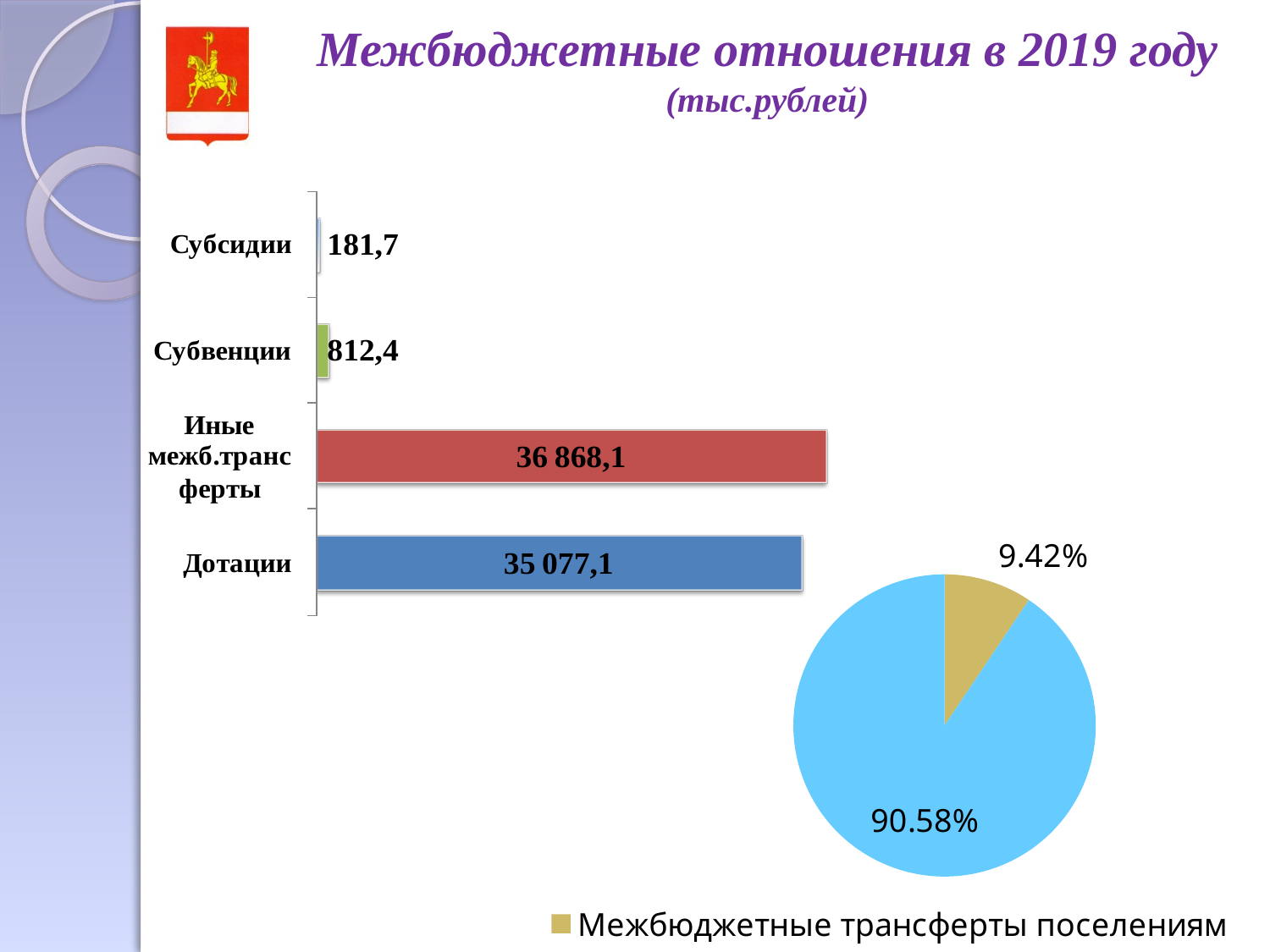
In the bar chart, what is the value for Субвенции? 812,4 In the bar chart, which is larger: Субвенции or Субсидии? Субвенции In the bar chart, what is the value for Субсидии? 181,7 In the bar chart, which category has the lowest value? Субсидии In the bar chart, what is the value for Иные межб.трансферты? 36 868,1 In the pie chart, what share does the slice for Межбюджетные трансферты поселениям have? 9.42% In the bar chart, which category has the highest value? Иные межб.трансферты In the pie chart, what is the percentage shown for the larger blue slice? 90.58% In the bar chart, what is the difference between Иные межб.трансферты and Дотации? 1 791,0 What kind of chart is the chart on the left of the slide? Bar chart In the bar chart, what is the value for Дотации? 35 077,1 How many categories does the bar chart show? 4